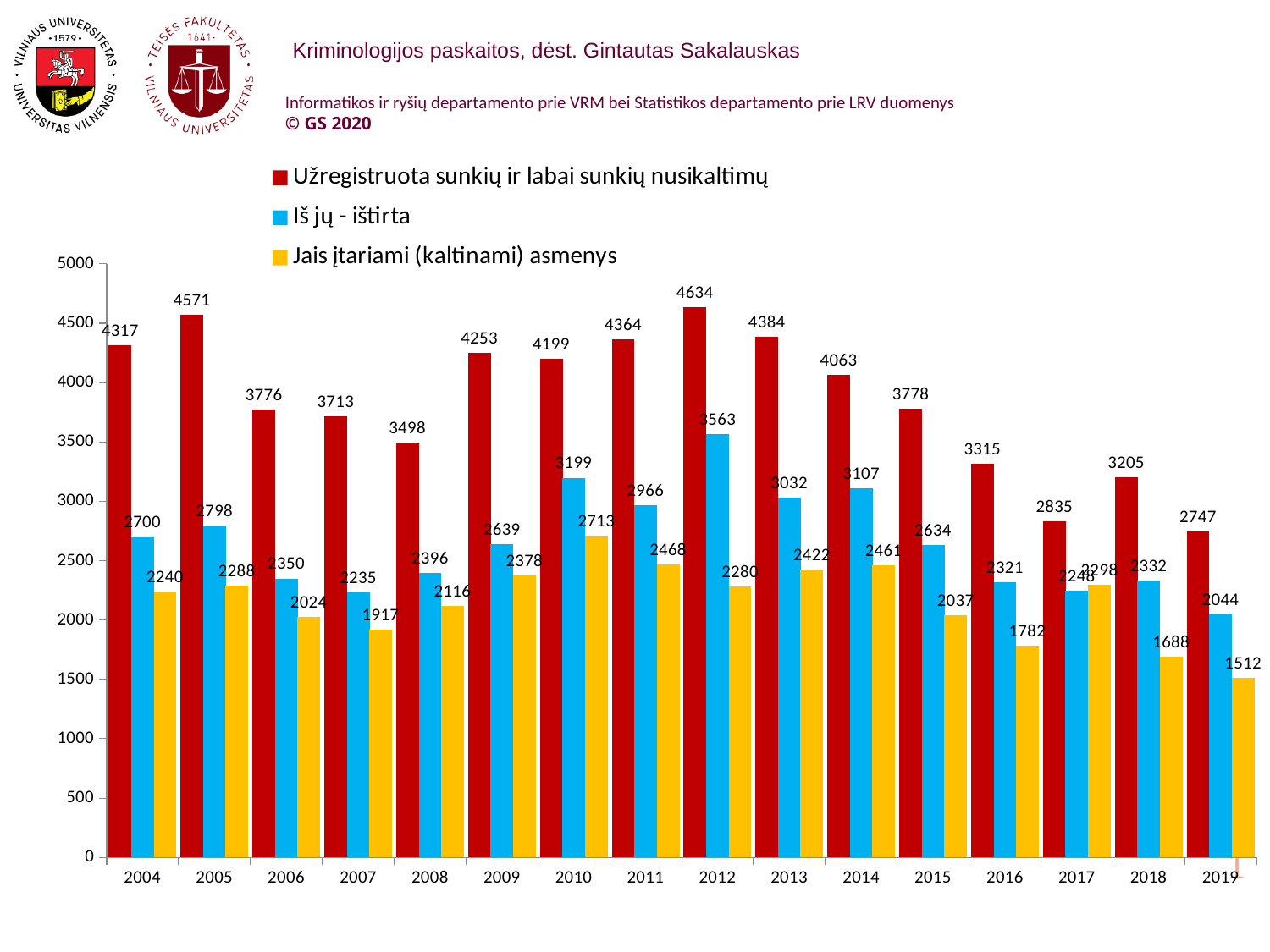
What is the value of 'Jais įtariami (kaltinami) asmenys' for 2019? 1512 Which is larger: 'Jais įtariami (kaltinami) asmenys' in 2010 or in 2016? 2010 In which year is 'Iš jų - ištirta' highest? 2012 What is the value of 'Užregistruota sunkių ir labai sunkių nusikaltimų' for 2012? 4634 How many years are shown on the x axis? 16 In which year is 'Užregistruota sunkių ir labai sunkių nusikaltimų' lowest? 2019 Which colour represents 'Iš jų - ištirta' in the chart? Blue What is the value of 'Iš jų - ištirta' for 2010? 3199 What is the difference between 'Užregistruota sunkių ir labai sunkių nusikaltimų' in 2005 and in 2019? 1824 In which year is 'Užregistruota sunkių ir labai sunkių nusikaltimų' highest? 2012 What kind of chart is shown on the slide? Bar chart How many series does the legend list? 3